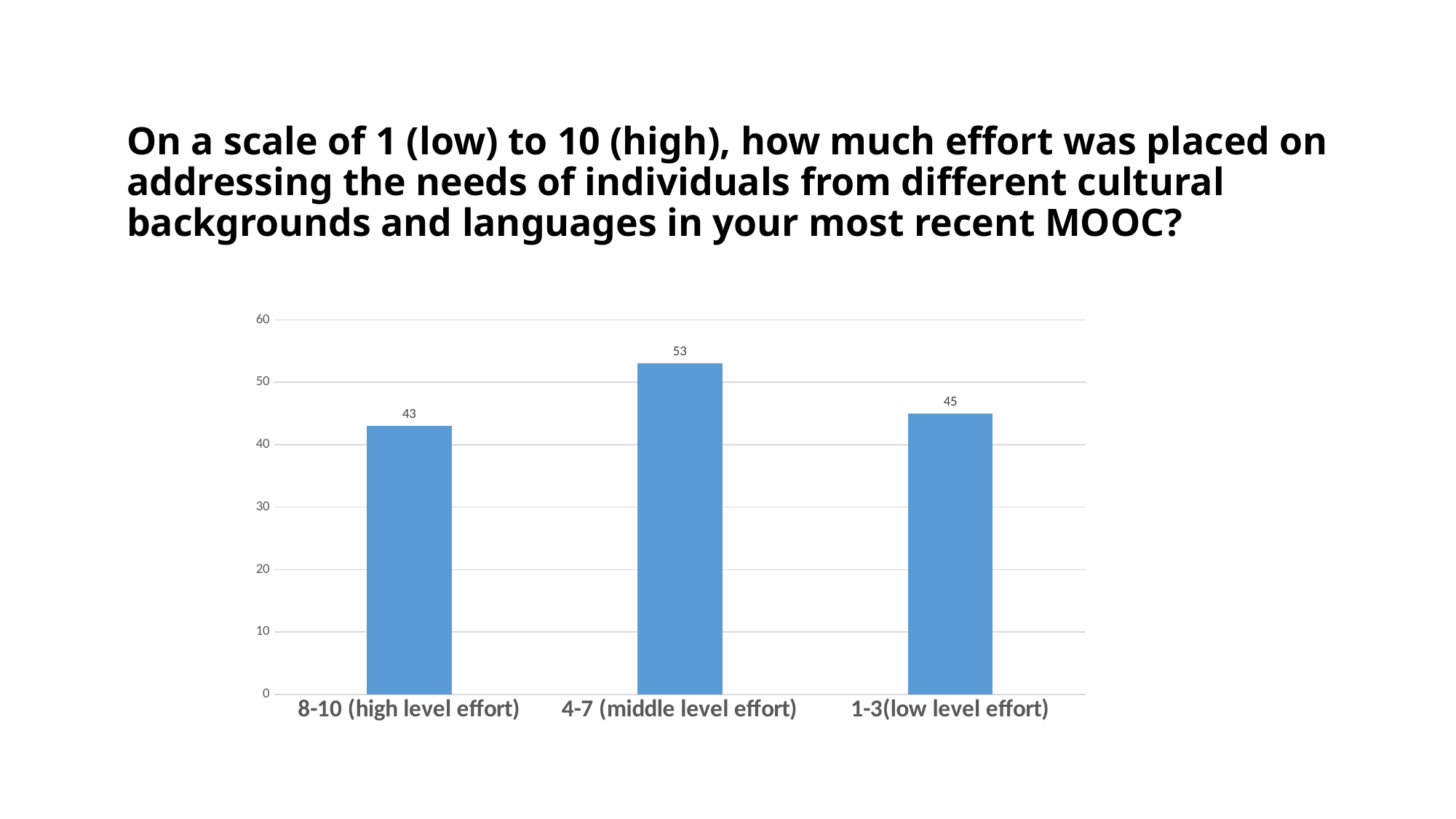
Which category has the highest value? 4-7 (middle level effort) Which category has the lowest value? 8-10 (high level effort) Which is larger, the value for 4-7 (middle level effort) or the value for 1-3(low level effort)? 4-7 (middle level effort) What is the difference between the values for 4-7 (middle level effort) and 8-10 (high level effort)? 10 What is the highest value shown on the vertical axis? 60 What is the value for 8-10 (high level effort)? 43 What kind of chart is shown on the slide? bar chart What is the value for 1-3(low level effort)? 45 What is the difference between the values for 1-3(low level effort) and 8-10 (high level effort)? 2 What is the value for 4-7 (middle level effort)? 53 How many categories are shown on the x axis? 3 Is the value for 4-7 (middle level effort) greater or less than 50? greater